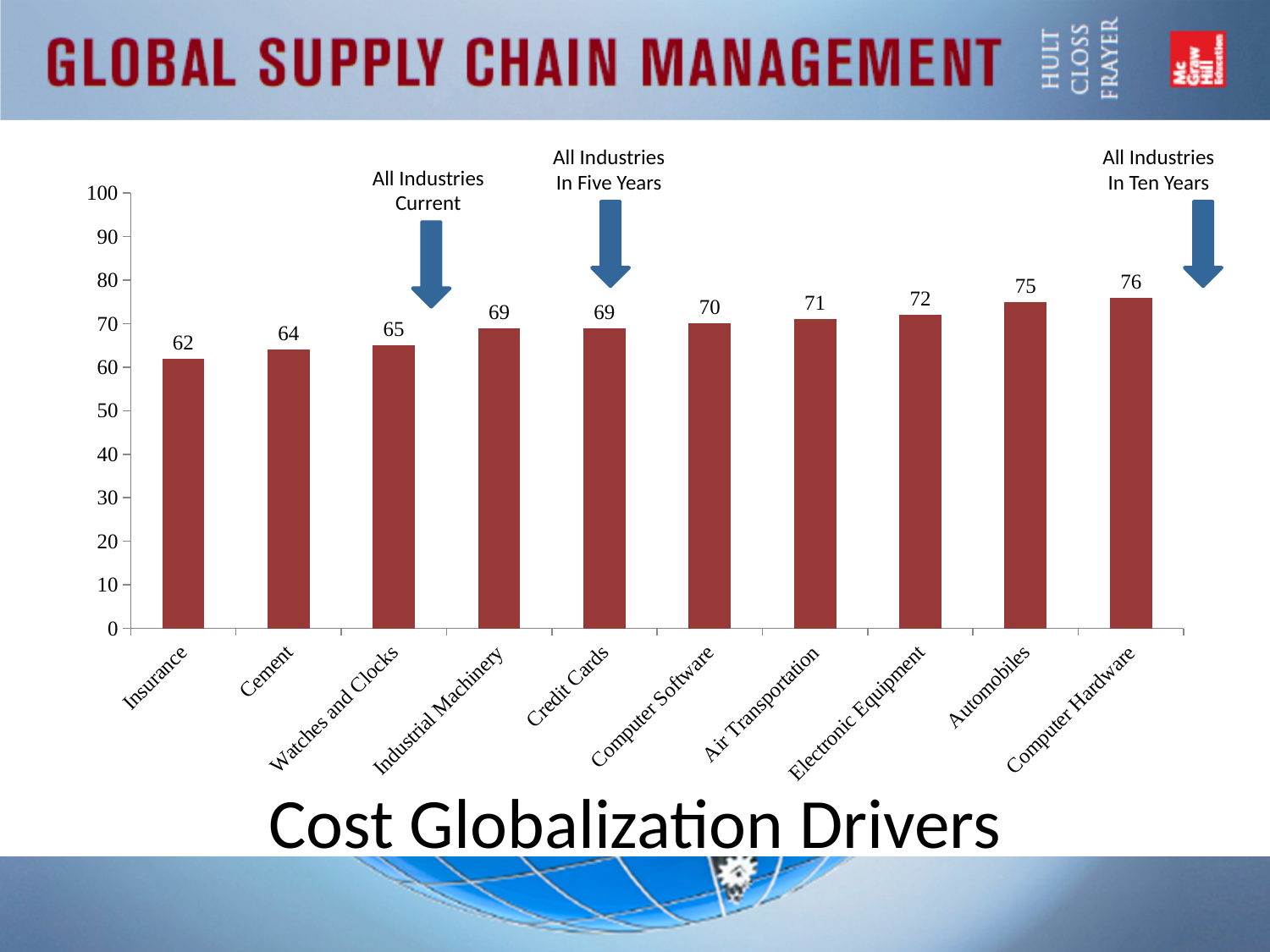
What is the title shown below the chart? Cost Globalization Drivers Which is larger, the value for Air Transportation or the value for Watches and Clocks? Air Transportation What is the difference between the values for Electronic Equipment and Cement? 8 What is the value for Computer Software? 70 What is the value for Insurance? 62 What is the value for Automobiles? 75 What is the difference between the values for Computer Hardware and Insurance? 14 Do the values rise or fall from left to right along the x axis? Rise Which category has the lowest value? Insurance How many categories are shown on the x axis? 10 What kind of chart is shown on the slide? Bar chart Which category has the highest value? Computer Hardware